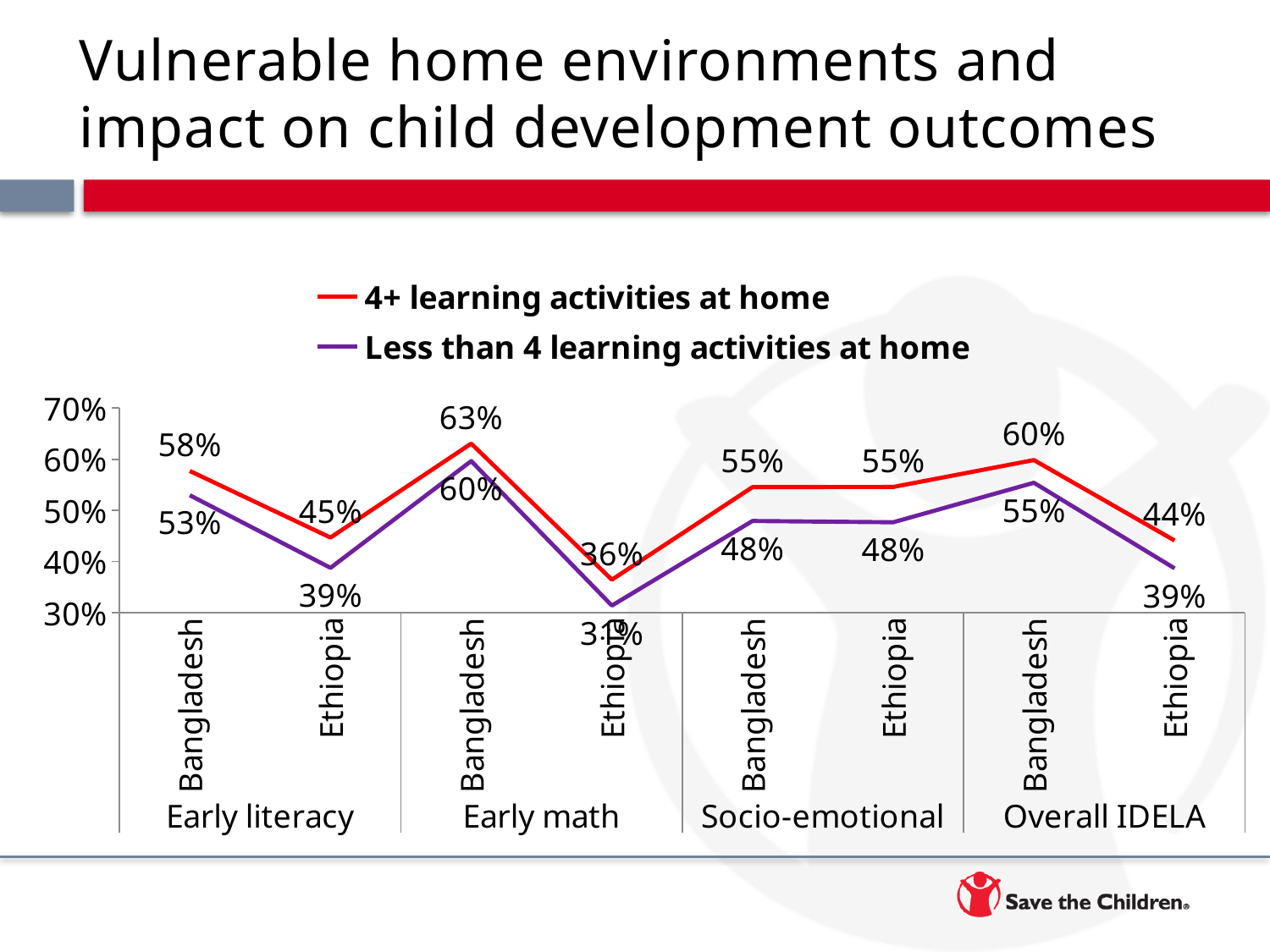
Which point has the highest value in the '4+ learning activities at home' series? Early math, Bangladesh What is the difference between the Overall IDELA values for Bangladesh in the '4+ learning activities at home' and 'Less than 4 learning activities at home' series? 5% For Early literacy in Ethiopia, which series has the larger value: '4+ learning activities at home' or 'Less than 4 learning activities at home'? 4+ learning activities at home What is the Early math value for Bangladesh in the 'Less than 4 learning activities at home' series? 60% What is the Overall IDELA value for Ethiopia in the '4+ learning activities at home' series? 44% What is the Early literacy value for Bangladesh in the '4+ learning activities at home' series? 58% What kind of chart is shown on the slide? line chart Which point has the lowest value in the '4+ learning activities at home' series? Early math, Ethiopia How many series does the legend list? 2 What is the Socio-emotional value for Ethiopia in the 'Less than 4 learning activities at home' series? 48% What colour is the line for the 'Less than 4 learning activities at home' series? purple How many data points are plotted along the x axis for each series? 8